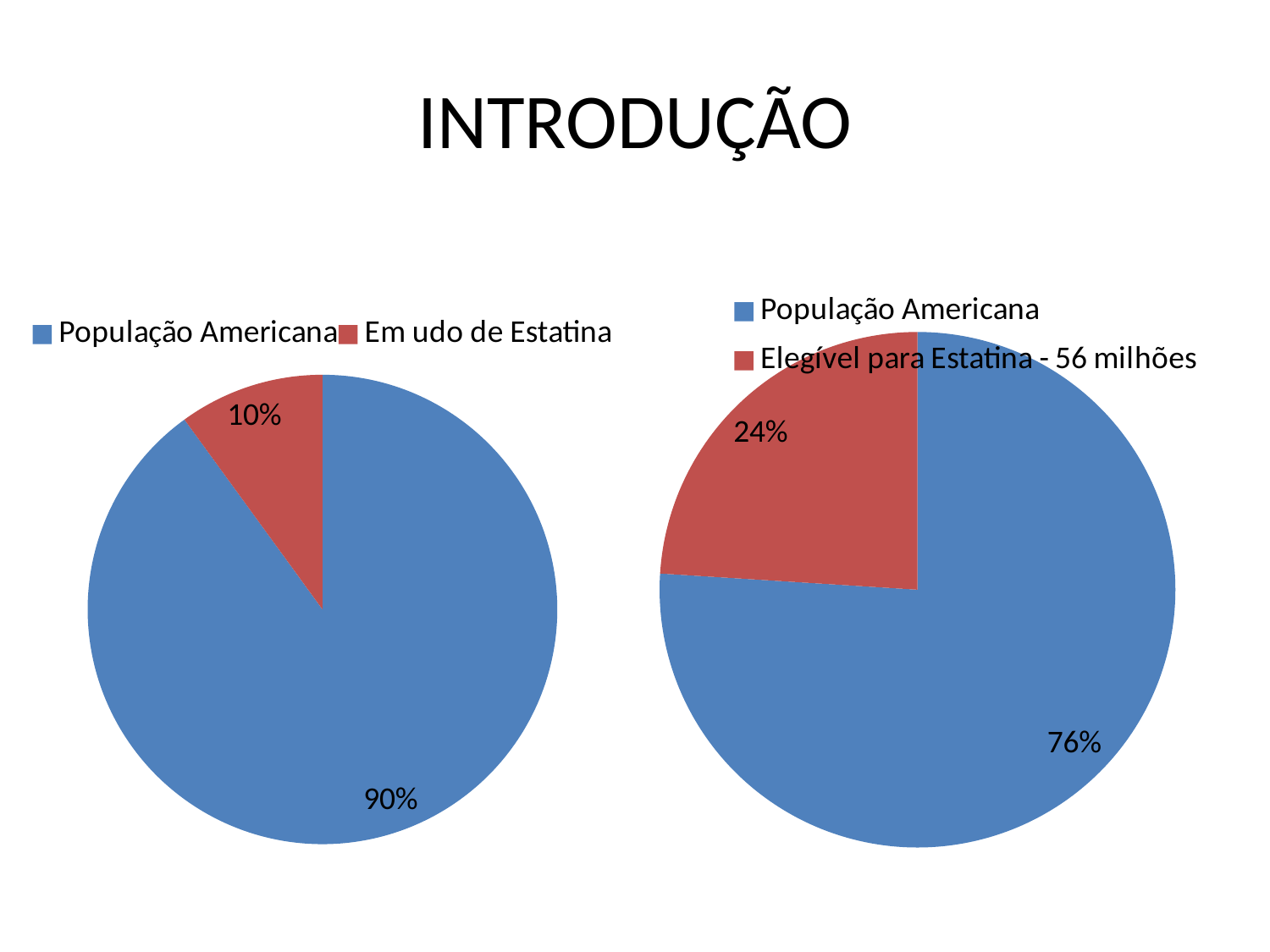
How many slices does the left pie chart have? 2 What type of chart is shown on the right side of the slide? Pie chart In the left pie chart, what is the difference between the 'População Americana' share and the 'Em udo de Estatina' share? 80% In the left pie chart, what share is labelled for 'Em udo de Estatina'? 10% In the right pie chart, what share is labelled for 'Elegível para Estatina - 56 milhões'? 24% In the right pie chart, what share is labelled for 'População Americana'? 76% Which is larger: the red slice in the left pie chart or the red slice in the right pie chart? The red slice in the right pie chart In the left pie chart, which slice is the largest? População Americana In the right pie chart, which slice is the smallest? Elegível para Estatina - 56 milhões In the right pie chart, what is the difference between the 'População Americana' share and the 'Elegível para Estatina - 56 milhões' share? 52% In the right pie chart, what colour is the 'Elegível para Estatina - 56 milhões' slice? Red